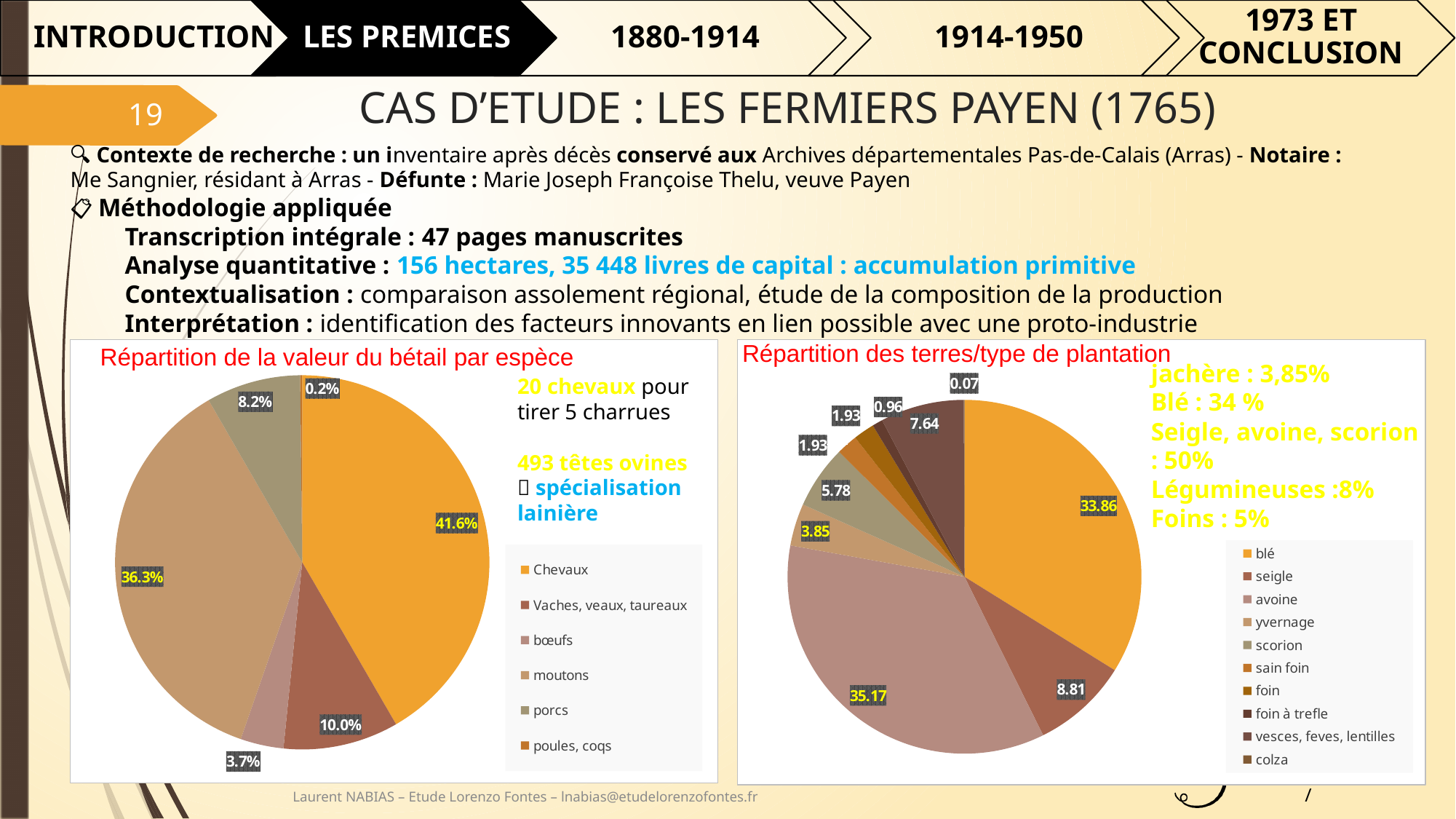
In the chart 'Répartition de la valeur du bétail par espèce', what is the value shown for moutons? 36.3% How many categories does the legend of the chart 'Répartition des terres/type de plantation' list? 10 In the chart 'Répartition de la valeur du bétail par espèce', which category has the smallest share? poules, coqs In the chart 'Répartition de la valeur du bétail par espèce', what is the difference between the shares of Chevaux and moutons? 5.3% In the chart 'Répartition des terres/type de plantation', which category has the largest share? avoine In the chart 'Répartition des terres/type de plantation', what value is shown for blé? 33.86 In the chart 'Répartition des terres/type de plantation', what value is shown for seigle? 8.81 In the chart 'Répartition des terres/type de plantation', which is larger: the share of scorion or the share of yvernage? scorion How many categories does the legend of the chart 'Répartition de la valeur du bétail par espèce' list? 6 What type of chart is 'Répartition des terres/type de plantation'? Pie chart In the chart 'Répartition de la valeur du bétail par espèce', which category has the largest share? Chevaux In the chart 'Répartition de la valeur du bétail par espèce', what share of the livestock value do Chevaux represent? 41.6%